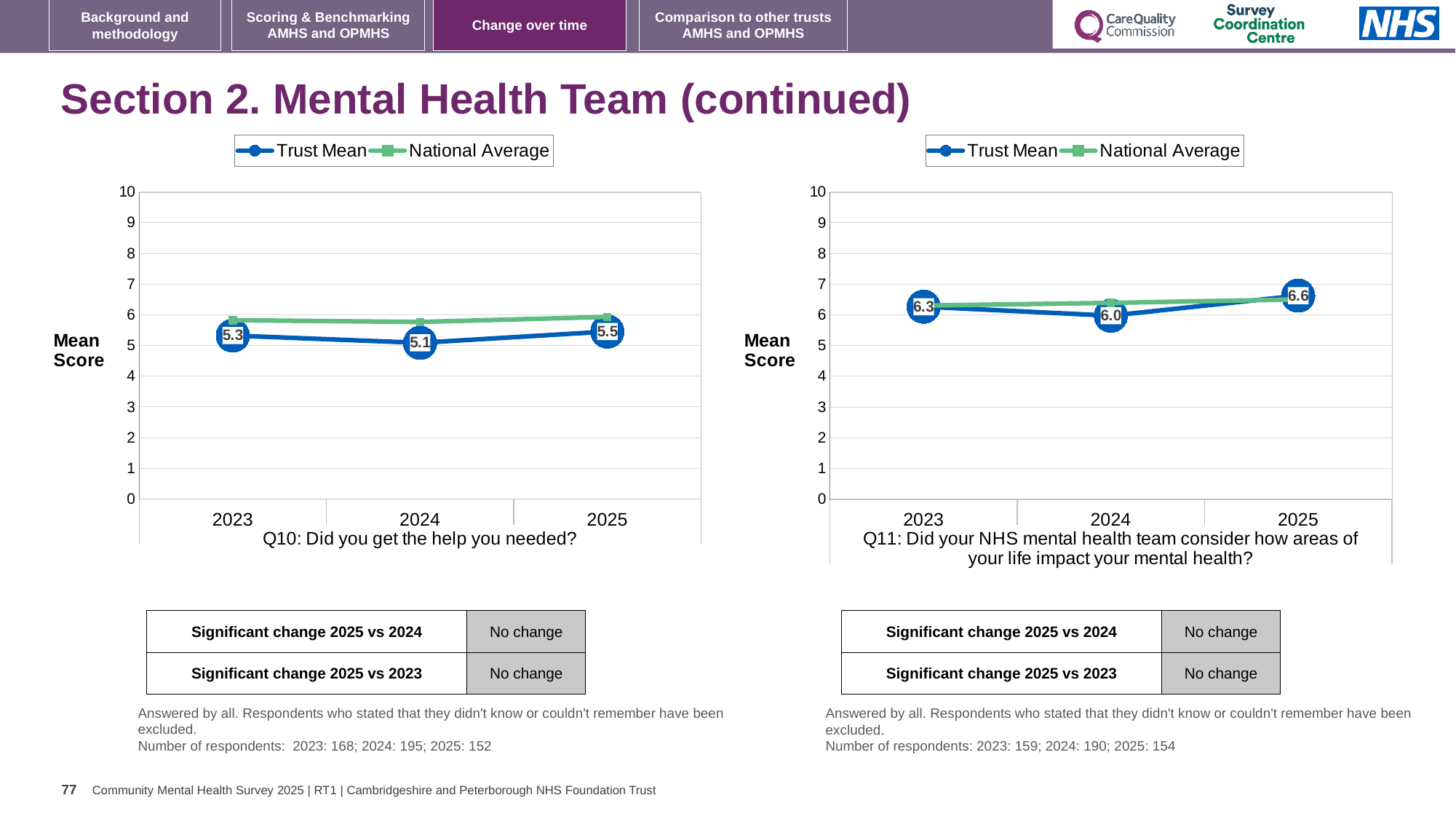
In the Q11 chart (right), does the Trust Mean rise or fall from 2024 to 2025? Rise In the Q10 chart (left), is the National Average for 2023 greater or less than 5? greater What type of chart is the Q11 chart (right)? Line chart How many years are shown on the x axis of the Q11 chart (right)? 3 In the Q11 chart (right), what is the difference between the Trust Mean for 2025 and 2024? 0.6 In the Q10 chart (left), is the Trust Mean higher in 2023 or 2025? 2025 In the Q10 chart (left), what is the Trust Mean for 2024? 5.1 In the Q11 chart (right), what is the Trust Mean for 2023? 6.3 In the Q11 chart (right), which year has the highest Trust Mean? 2025 How many series does the legend of the Q10 chart (left) list? 2 In the Q10 chart (left), what is the Trust Mean for 2025? 5.5 In the Q10 chart (left), which year has the lowest Trust Mean? 2024